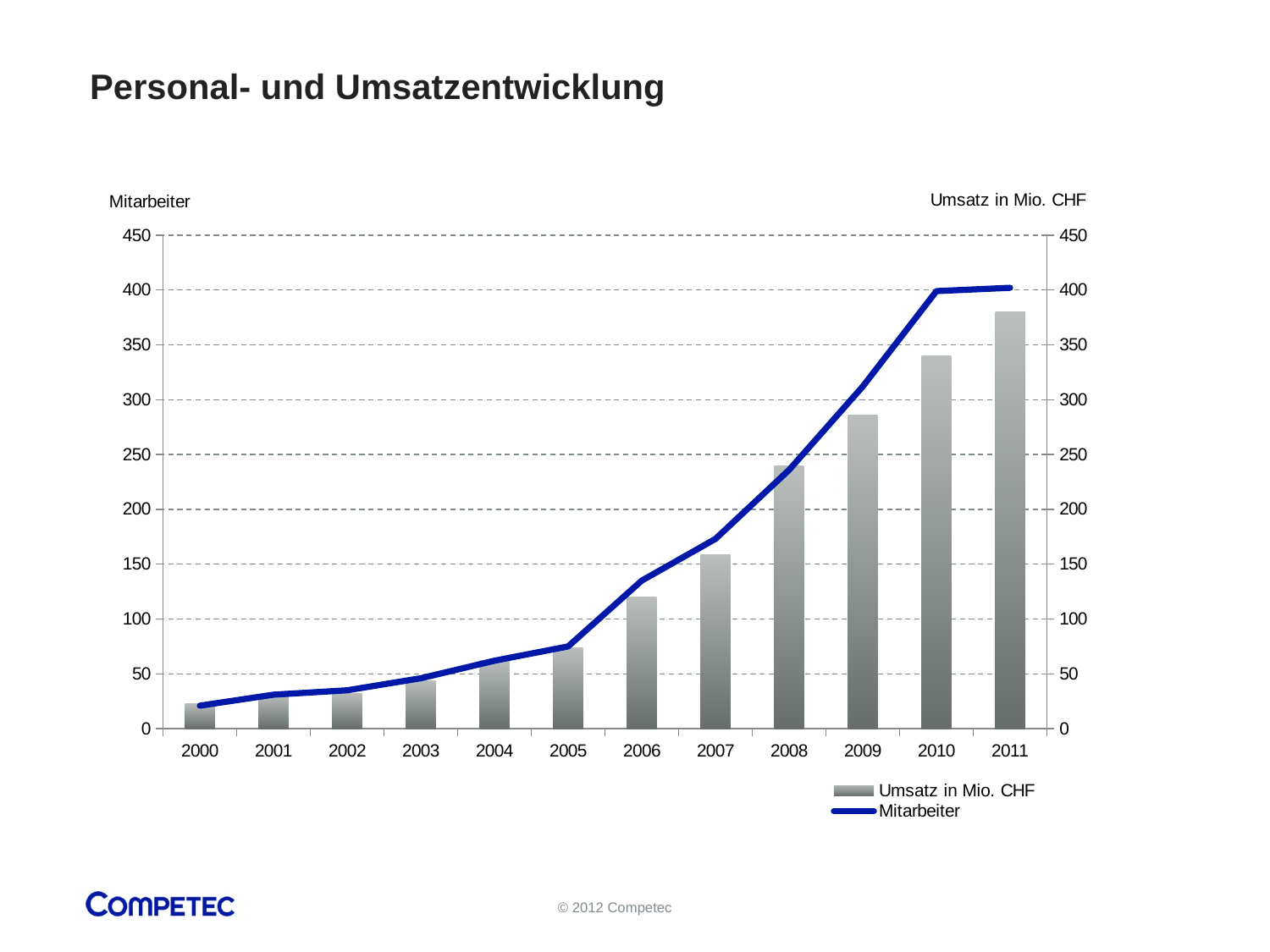
Which year has the highest Umsatz in Mio. CHF bar? 2011 Which series is drawn as a line rather than bars? Mitarbeiter Do the Mitarbeiter values rise or fall from 2000 to 2011? rise Is the Umsatz in Mio. CHF value for 2009 greater or less than 250? greater Which is larger, the Umsatz in Mio. CHF bar for 2008 or for 2010? 2010 How many series does the legend list? 2 Is the Mitarbeiter value for 2009 greater or less than 300? greater What is the title of the chart? Personal- und Umsatzentwicklung Is the Umsatz in Mio. CHF value for 2006 greater or less than 150? less How many years are shown on the x axis? 12 Which year has the lowest Umsatz in Mio. CHF bar? 2000